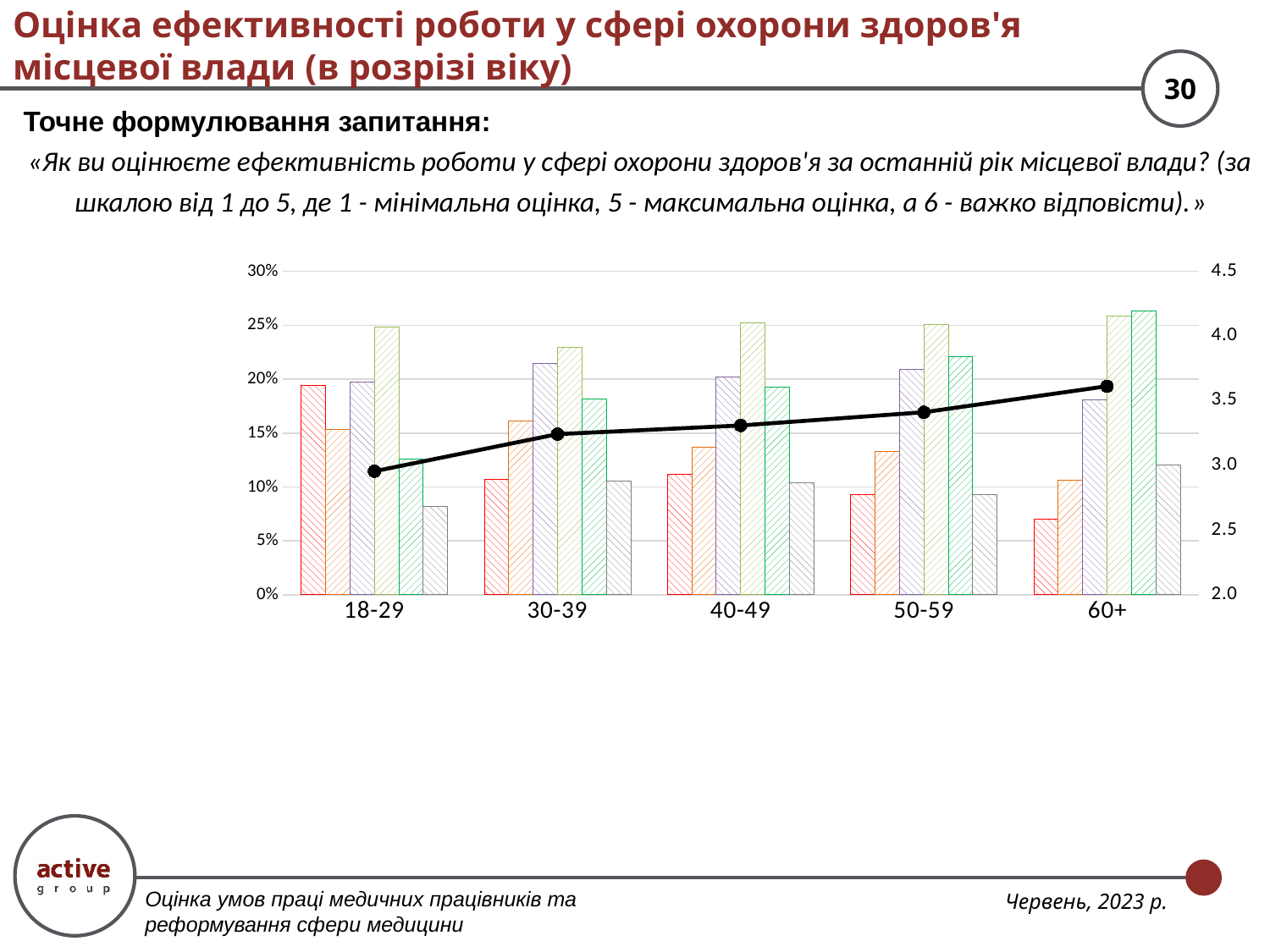
Is the red bar for the 60+ age group greater or less than 10%? less What is the highest tick value shown on the right-hand axis of the chart? 4.5 For which age group is the black line at its highest point? 60+ How many bars are plotted for each age group in the chart? 6 For which age group is the black line at its lowest point? 18-29 Is the value of the black line for 30-39 greater or less than 3.0 on the right axis? greater Is the value of the black line for 18-29 greater or less than 3.5 on the right axis? less Does the black line rise or fall as the age groups move from 18-29 to 60+? It rises How many age groups are shown on the x axis of the chart? 5 What kind of chart is shown on the slide? A combination bar and line chart